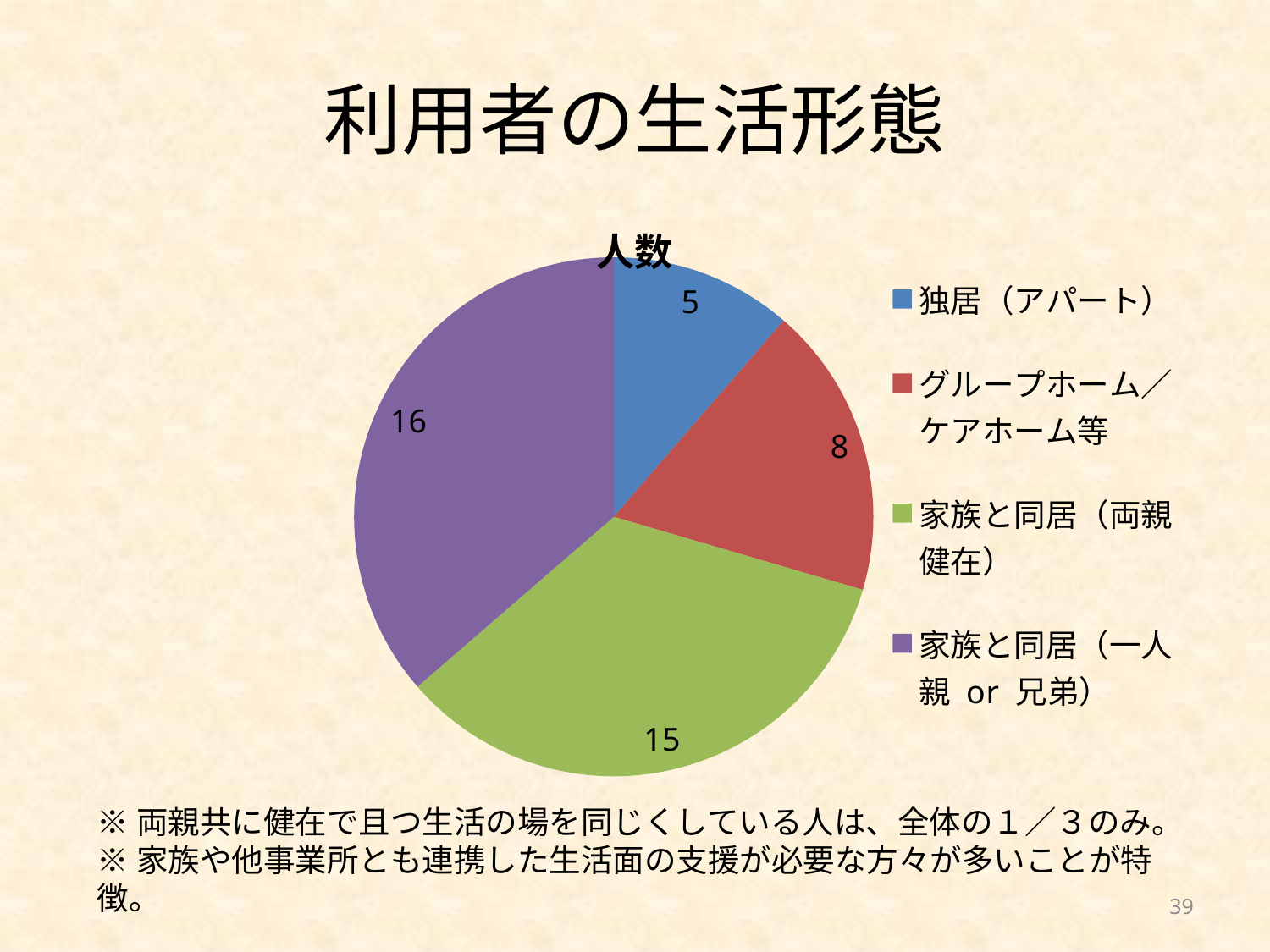
What type of chart is shown on the slide? pie chart Which category has the largest value? 家族と同居（一人親 or 兄弟） Which category has the smallest value? 独居（アパート） What is the title of the chart? 人数 Which is larger, the value for 独居（アパート） or the value for グループホーム／ケアホーム等? グループホーム／ケアホーム等 What is the difference between the values for 家族と同居（両親健在） and グループホーム／ケアホーム等? 7 How many slices does the pie chart have? 4 What is the value for 家族と同居（一人親 or 兄弟）? 16 What is the value for 独居（アパート）? 5 What is the value for グループホーム／ケアホーム等? 8 What is the total of all slices in the pie chart? 44 What is the value for 家族と同居（両親健在）? 15